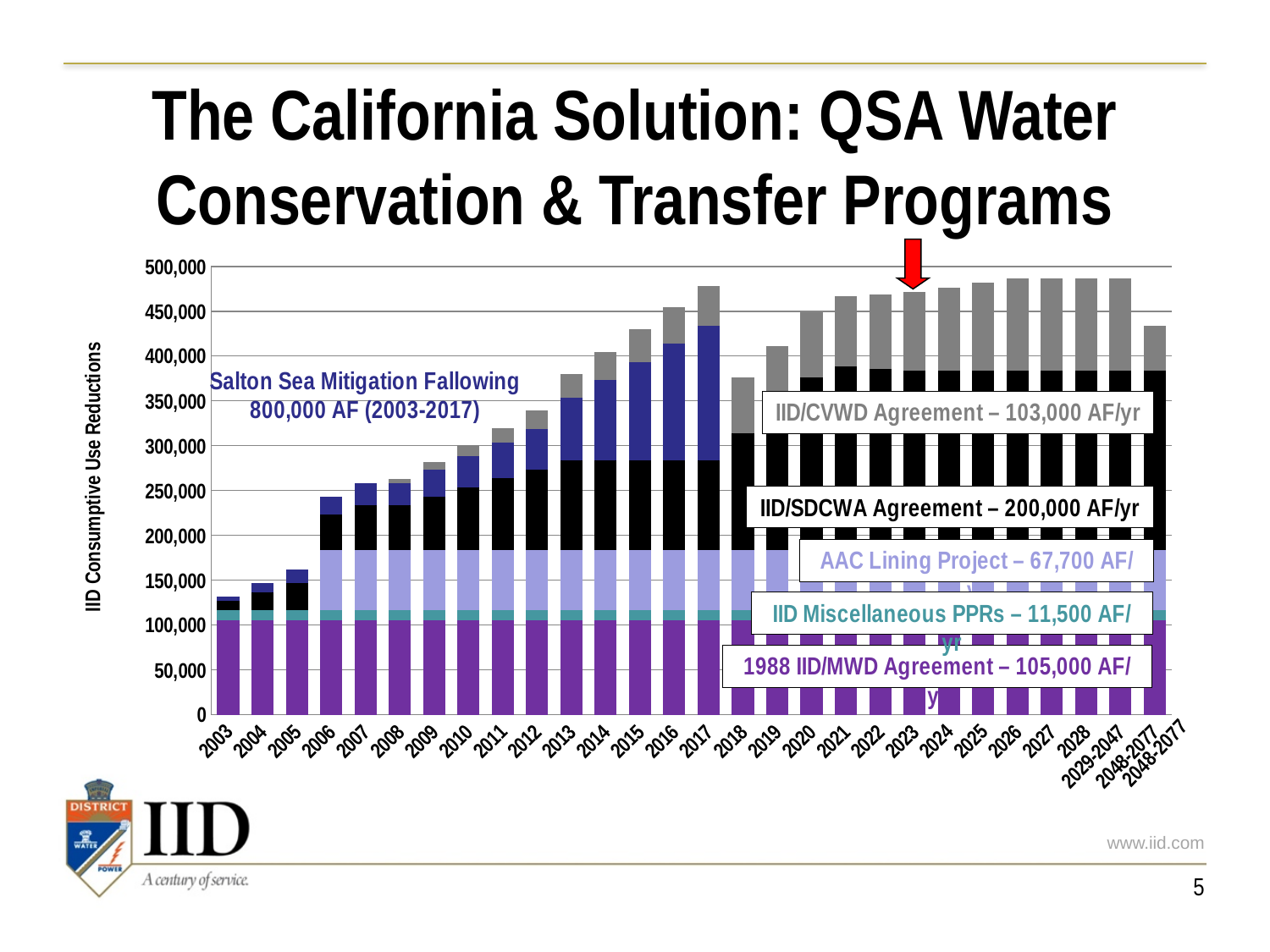
Is the total value for 2013 greater or less than 350,000? greater Which year has the larger total bar, 2017 or 2018? 2017 Is the total value for 2018 greater or less than 400,000? less Do the total bar values rise or fall from 2003 to 2017? rise According to the annotation on the chart, how much water per year is the IID/SDCWA Agreement? 200,000 AF/yr According to the annotation on the chart, how much water per year is the IID/CVWD Agreement? 103,000 AF/yr Which year has the lowest total bar? 2003 Is the total value for 2026 greater or less than 450,000? greater Which year has the larger total bar, 2003 or 2006? 2006 What kind of chart is shown on the slide? bar chart